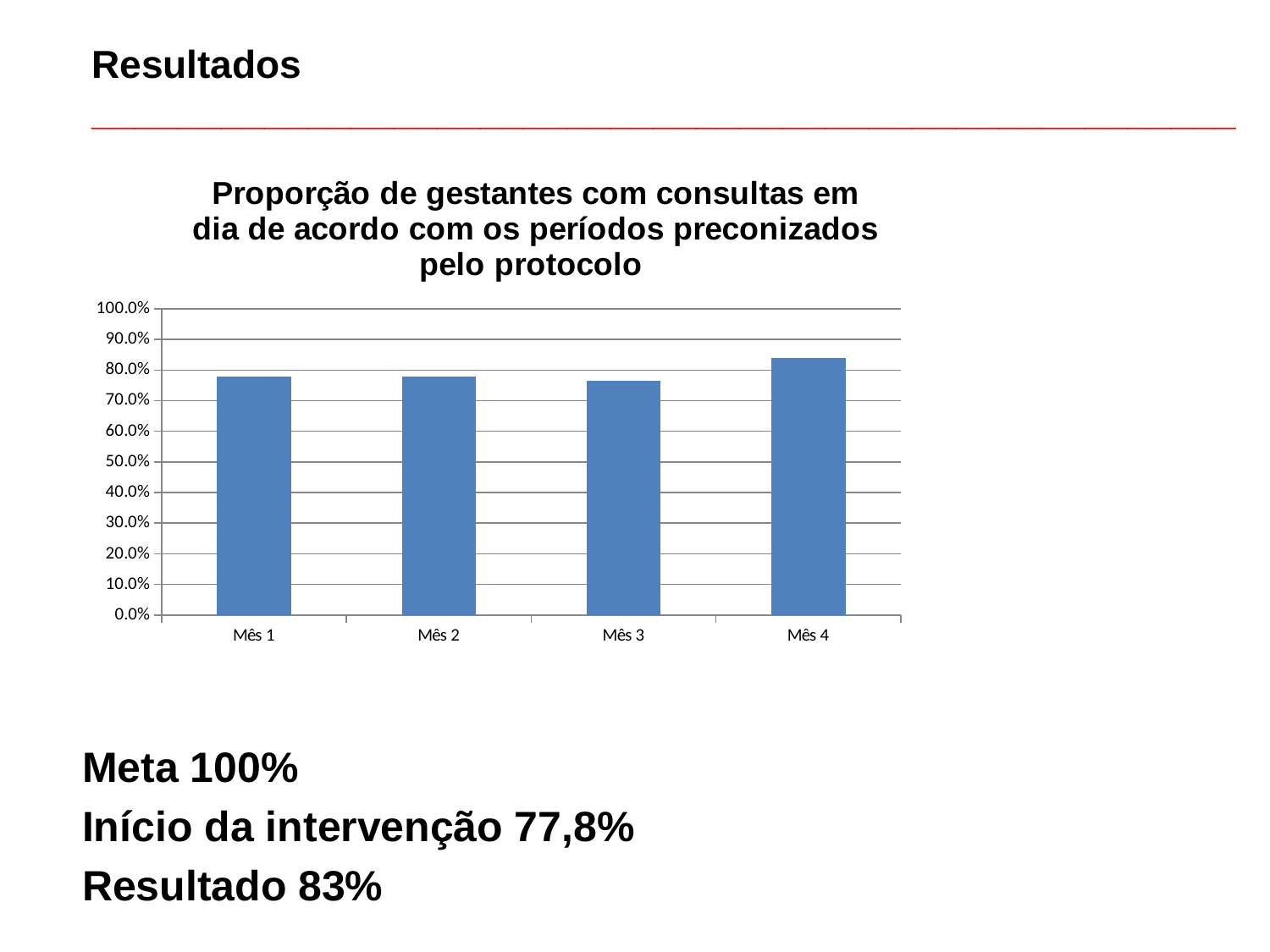
What is the title of the chart? Proporção de gestantes com consultas em dia de acordo com os períodos preconizados pelo protocolo Which is larger, the value for Mês 4 or the value for Mês 3? Mês 4 Is the value for Mês 2 greater or less than 90.0%? less Which month has the highest proportion? Mês 4 Is the value for Mês 1 greater or less than 80.0%? less Do any of the bars reach the 100.0% line at the top of the axis? No Which is larger, the value for Mês 1 or the value for Mês 4? Mês 4 What is the highest tick value shown on the y axis? 100.0% What kind of chart is shown on the slide? bar chart How many months (categories) are plotted on the x axis? 4